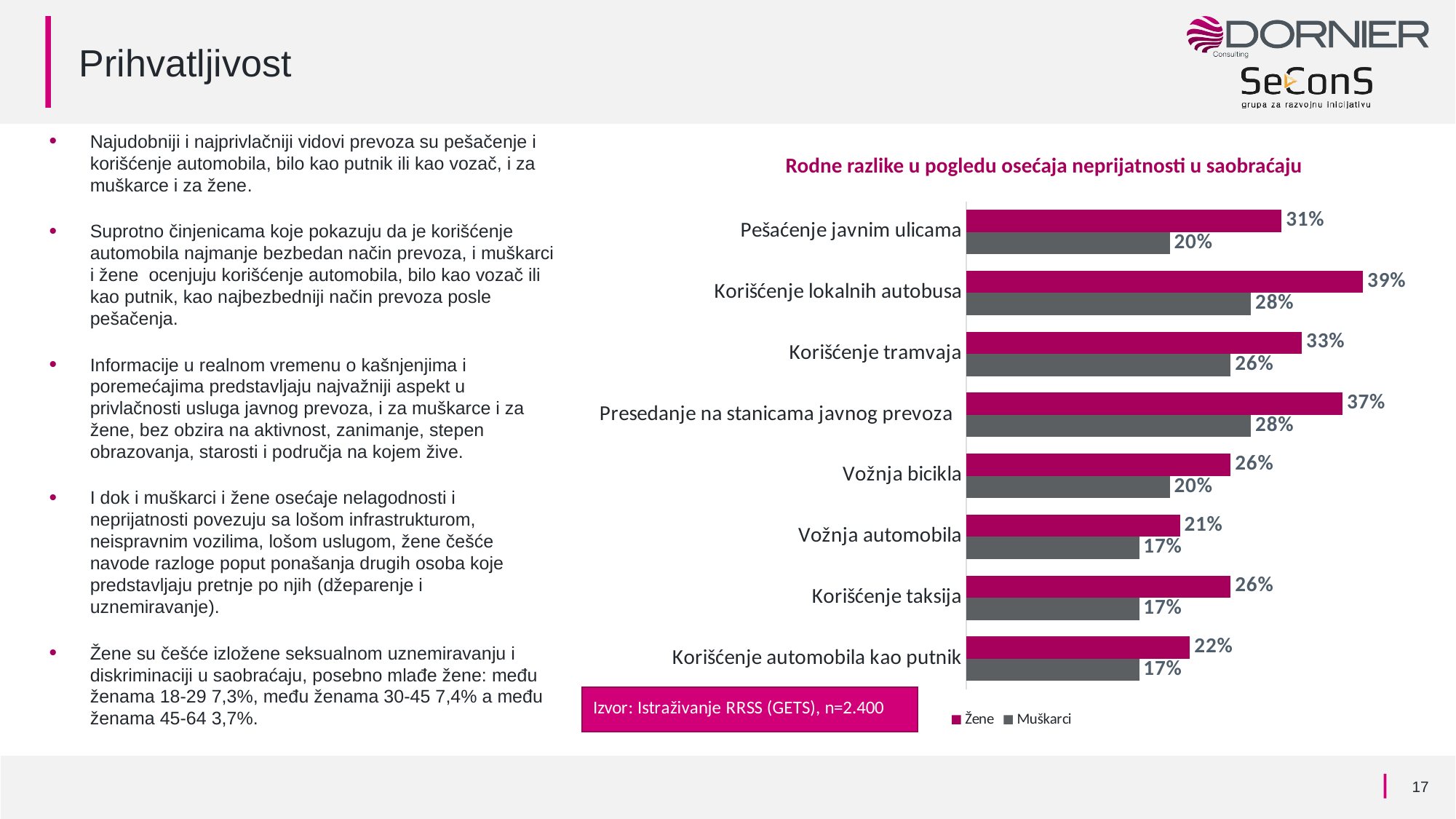
What is the value for Muškarci for Pešaćenje javnim ulicama? 20% Which category has the lowest value for Žene? Vožnja automobila What is the difference between the Žene and Muškarci values for Pešaćenje javnim ulicama? 11% What is the difference between the Žene and Muškarci values for Korišćenje taksija? 9% What is the value for Žene for Korišćenje lokalnih autobusa? 39% How many categories are shown in the chart? 8 How many series does the legend list? 2 What is the value for Žene for Vožnja automobila? 21% Which category has the highest value for Žene? Korišćenje lokalnih autobusa What is the title of the chart? Rodne razlike u pogledu osećaja neprijatnosti u saobraćaju What kind of chart is shown on the slide? Bar chart Which is larger for Presedanje na stanicama javnog prevoza, the Žene value or the Muškarci value? Žene